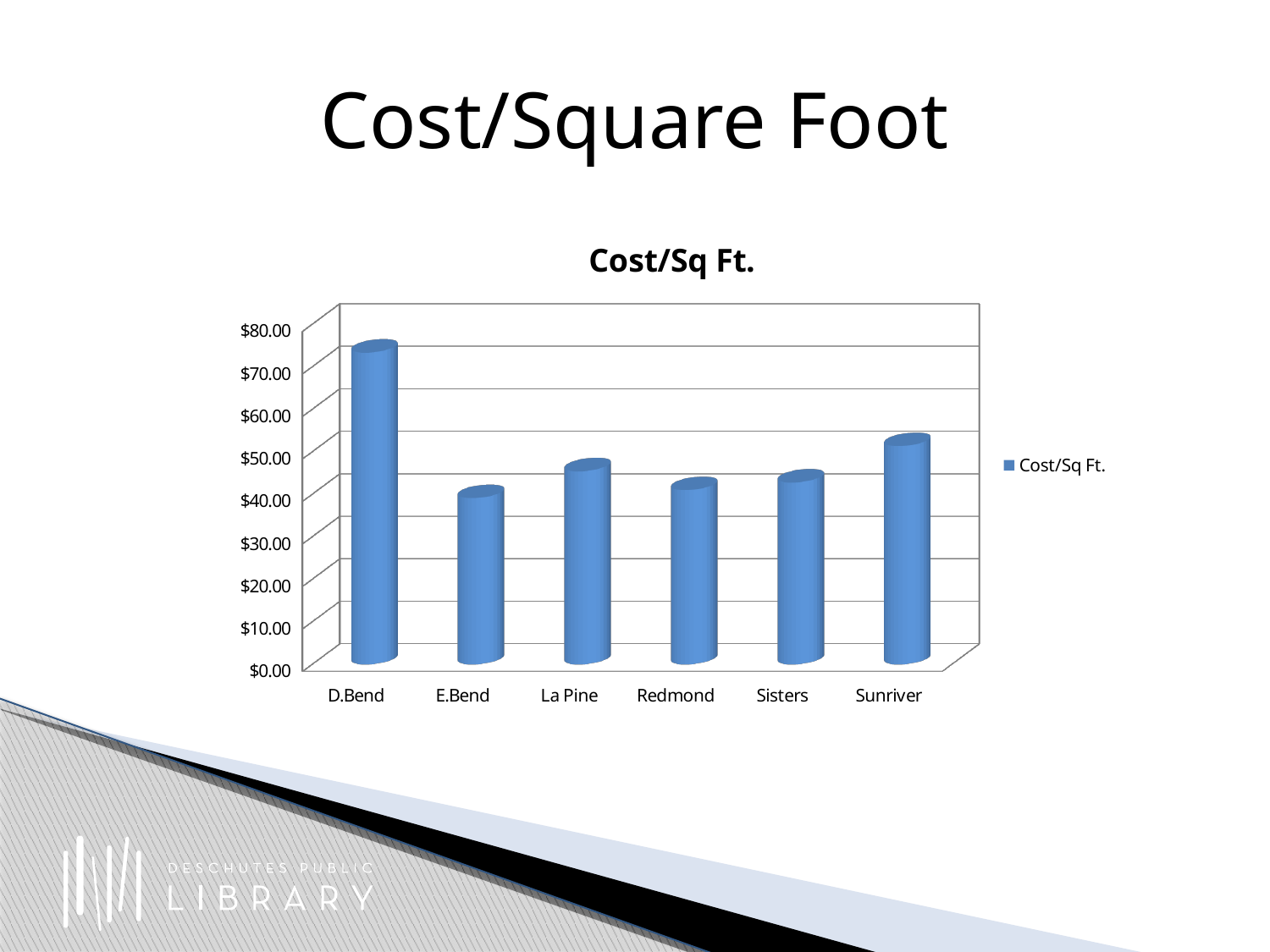
Is the value for D.Bend greater or less than $60.00? greater Is the value for La Pine greater or less than $60.00? less Which category has the lowest cost per square foot? E.Bend How many series does the chart's legend list? 1 Which is larger, the value for Sunriver or the value for E.Bend? Sunriver How many categories are shown on the x axis of the chart? 6 Which is larger, the value for D.Bend or the value for Sunriver? D.Bend Is the value for E.Bend greater or less than $50.00? less Which category has the highest cost per square foot? D.Bend What kind of chart is shown on the slide? bar chart What is the title shown above the chart? Cost/Sq Ft.